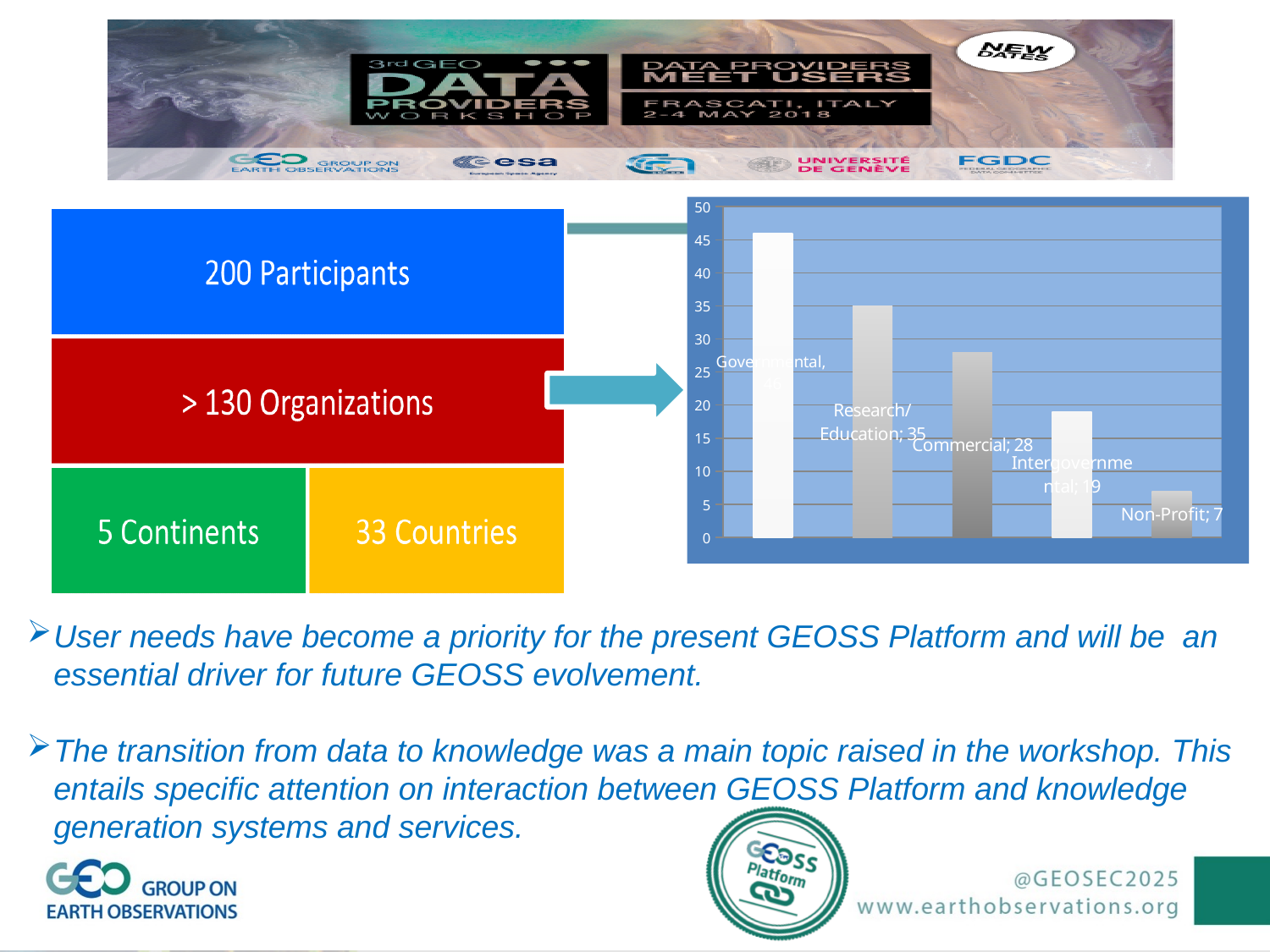
What is the difference between the Research/Education and Commercial values? 7 What is the value for Commercial in the bar chart? 28 What is the value for Research/Education in the bar chart? 35 How many categories are shown in the bar chart? 5 Is the value for Governmental greater or less than 40? greater What is the value for Non-Profit in the bar chart? 7 What is the difference between the Commercial and Intergovernmental values? 9 Do the bar values rise or fall from left to right across the chart? fall What is the value for Intergovernmental in the bar chart? 19 Which category has the lowest bar in the chart? Non-Profit Which is larger, the value for Commercial or the value for Intergovernmental? Commercial Which category has the highest bar in the chart? Governmental